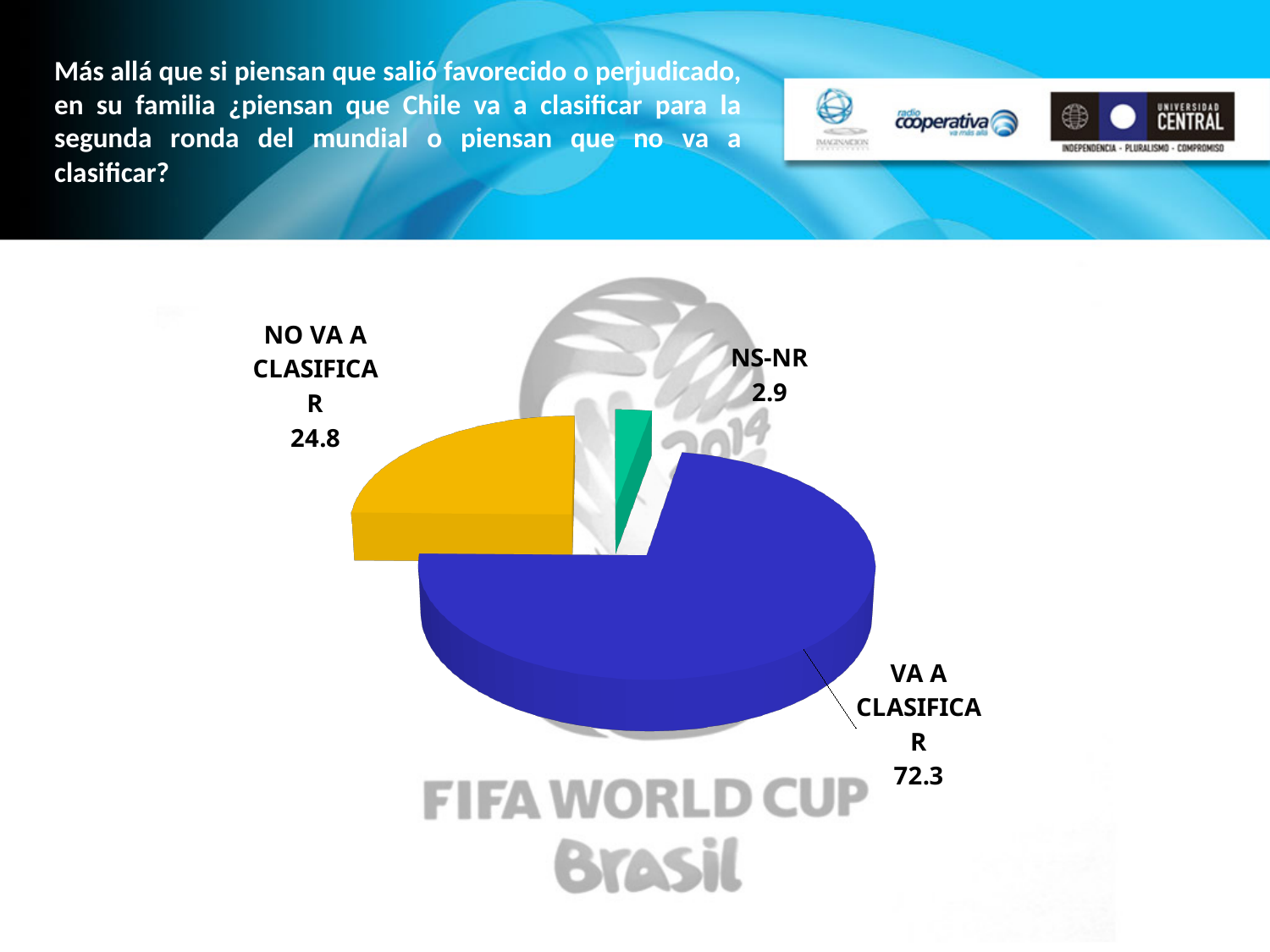
How many slices does the pie chart have? 3 What is the difference between the values for NO VA A CLASIFICAR and NS-NR? 21.9 What is the value for NO VA A CLASIFICAR? 24.8 What is the value for VA A CLASIFICAR? 72.3 What colour is the NO VA A CLASIFICAR slice? yellow What kind of chart is shown on the slide? pie chart What colour is the VA A CLASIFICAR slice? blue Which category has the smallest slice? NS-NR Which category has the largest slice? VA A CLASIFICAR What is the difference between the values for VA A CLASIFICAR and NO VA A CLASIFICAR? 47.5 Which is larger, NO VA A CLASIFICAR or NS-NR? NO VA A CLASIFICAR What is the value for NS-NR? 2.9